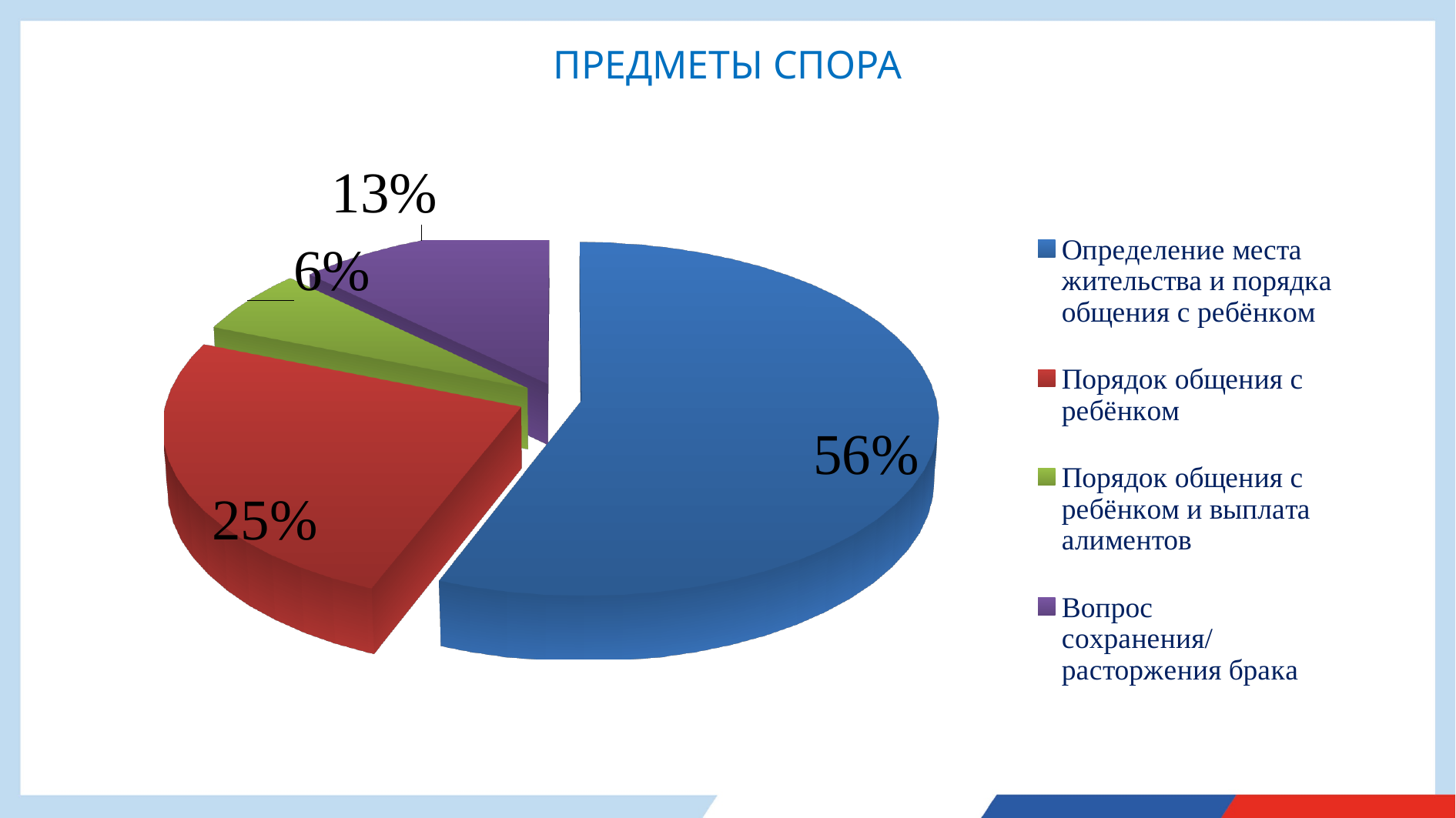
Which is larger: the slice for "Вопрос сохранения/расторжения брака" or the slice for "Порядок общения с ребёнком и выплата алиментов"? Вопрос сохранения/расторжения брака What colour is the slice for "Порядок общения с ребёнком"? red Which category has the smallest slice of the pie? Порядок общения с ребёнком и выплата алиментов What share of the pie is labelled for "Определение места жительства и порядка общения с ребёнком"? 56% What kind of chart is shown on the slide? pie chart What share of the pie is labelled for "Порядок общения с ребёнком и выплата алиментов"? 6% How many categories does the legend list? 4 What is the title of the chart? ПРЕДМЕТЫ СПОРА Which category has the largest slice of the pie? Определение места жительства и порядка общения с ребёнком What share of the pie is labelled for "Вопрос сохранения/расторжения брака"? 13% What is the difference in percentage points between the slices for "Определение места жительства и порядка общения с ребёнком" and "Порядок общения с ребёнком"? 31 What share of the pie is labelled for "Порядок общения с ребёнком"? 25%